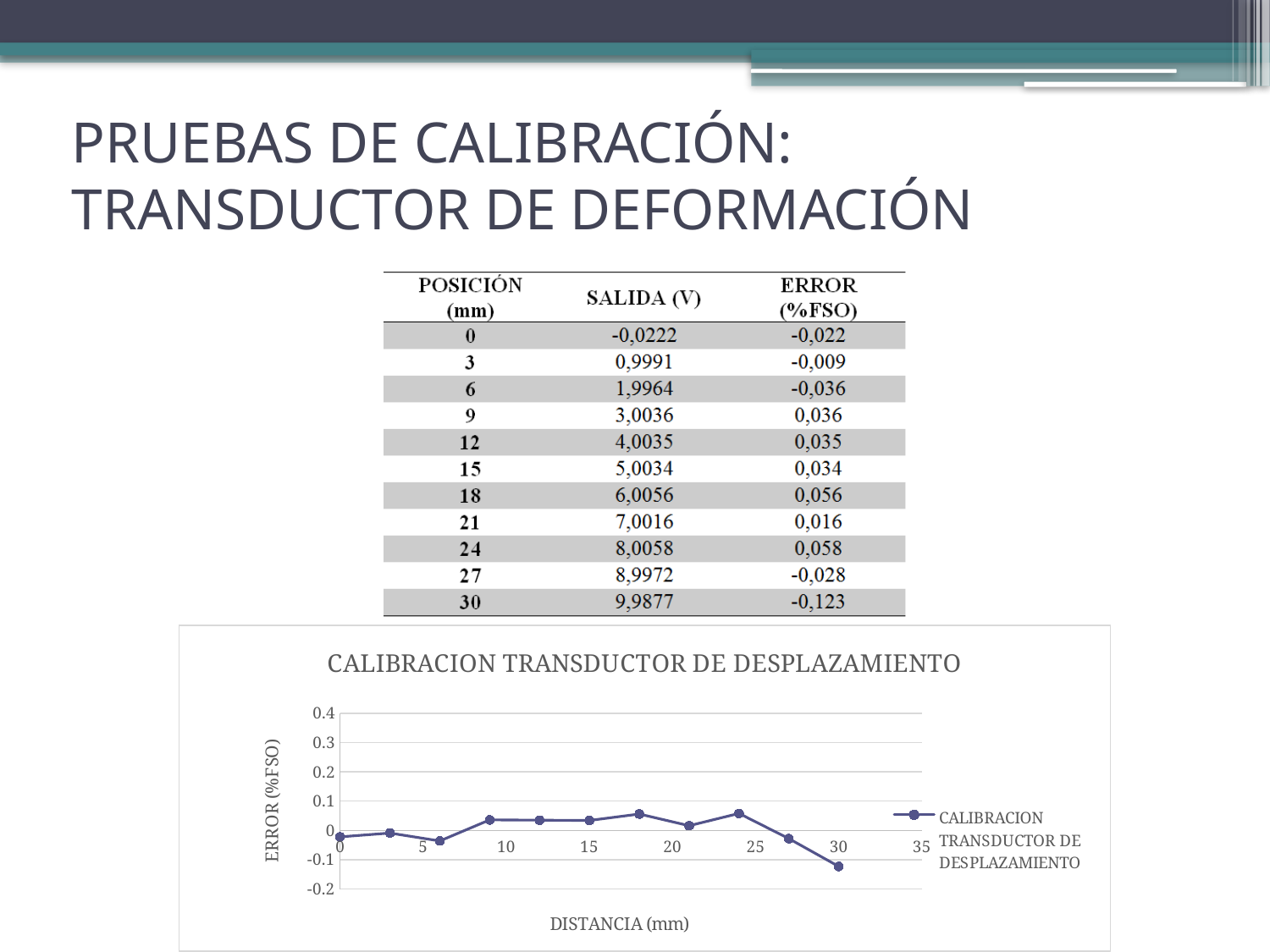
Which has the larger plotted error, 24 mm or 27 mm? 24 mm What is the label of the y axis of the chart? ERROR (%FSO) How many series does the chart legend list? 1 How many data points are plotted on the line in the chart? 11 Is the plotted error at 9 mm greater or less than 0? greater According to the table, what is the ERROR (%FSO) at position 30 mm? -0,123 What is the title of the chart? CALIBRACION TRANSDUCTOR DE DESPLAZAMIENTO Is the plotted error at 6 mm greater or less than 0? less According to the table, what is the SALIDA (V) at position 15 mm? 5,0034 At which distance (mm) is the plotted error lowest? 30 What kind of chart is shown on the slide? line chart Is the plotted error at 30 mm greater or less than -0.1? less